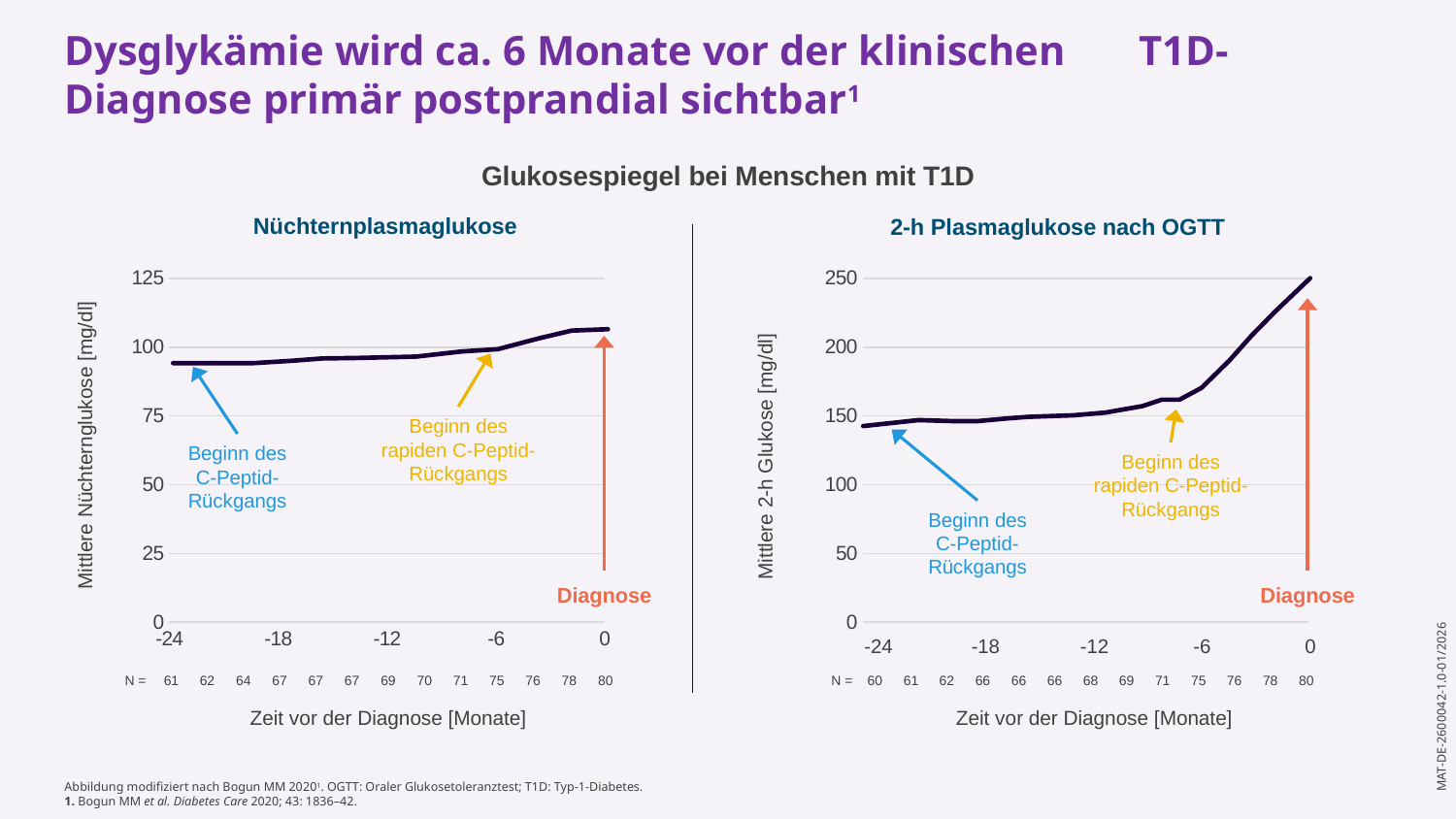
What kind of chart is the left chart titled "Nüchternplasmaglukose"? line chart In the right chart (2-h Plasmaglukose nach OGTT), is the value at -24 months greater or less than 150? less In the right chart (2-h Plasmaglukose nach OGTT), which is larger: the value at -24 months or the value at 0 months? 0 months What is the overall title shown above the two charts? Glukosespiegel bei Menschen mit T1D In the left chart (Nüchternplasmaglukose), do the values rise or fall from -24 to 0 months? rise In the right chart (2-h Plasmaglukose nach OGTT), is the value at 0 months (Diagnose) greater or less than 200? greater In the left chart (Nüchternplasmaglukose), is the value at 0 months (Diagnose) greater or less than 100? greater In the right chart (2-h Plasmaglukose nach OGTT), do the values rise or fall as time approaches the diagnosis (from -24 to 0 months)? rise What is the y-axis label of the right chart (2-h Plasmaglukose nach OGTT)? Mittlere 2-h Glukose [mg/dl] In the right chart (2-h Plasmaglukose nach OGTT), at which time point is the glucose value highest? 0 (Diagnose)